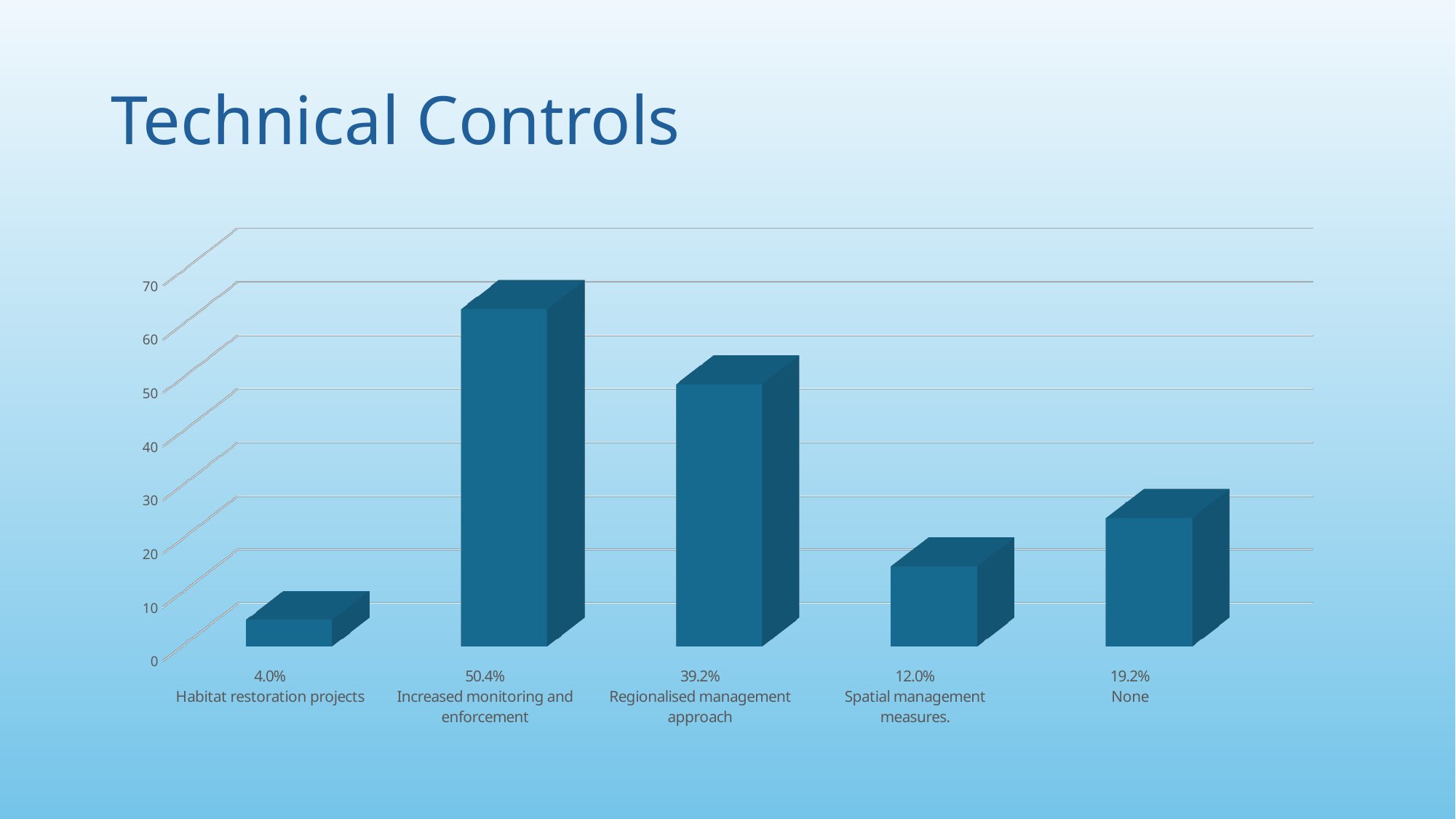
How many categories are shown in the chart? 5 Which bar is taller: None or Spatial management measures? None What is the title of the chart on the slide? Technical Controls What kind of chart is shown on the slide? bar chart What is the difference between the percentages printed for Increased monitoring and enforcement and Regionalised management approach? 11.2% What percentage is printed in the label for Regionalised management approach? 39.2% Is the value for Habitat restoration projects greater or less than 10? less Which category has the lowest bar? Habitat restoration projects What percentage is printed in the label for None? 19.2% What percentage is printed in the label for Spatial management measures? 12.0% Which category has the highest bar? Increased monitoring and enforcement Is the value for Increased monitoring and enforcement greater or less than 60? greater